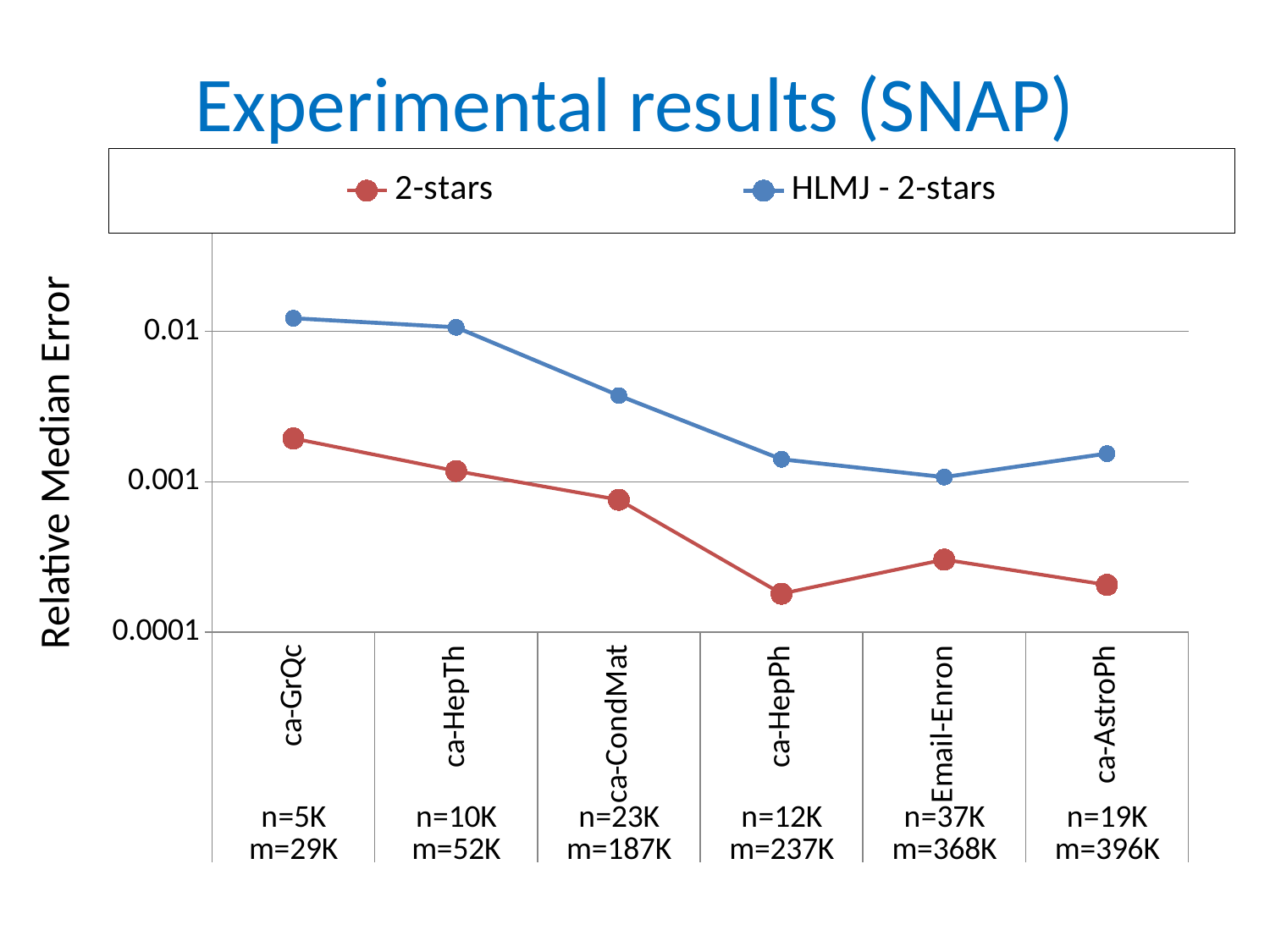
Is the HLMJ - 2-stars value for ca-GrQc greater or less than 0.01? greater For which dataset is the 2-stars series lowest? ca-HepPh How many series does the legend list? 2 What is the title of the slide containing the chart? Experimental results (SNAP) Is the 2-stars value for ca-HepPh greater or less than 0.001? less For which dataset is the HLMJ - 2-stars series highest? ca-GrQc Is the HLMJ - 2-stars value for ca-CondMat greater or less than 0.01? less At ca-HepPh, which series has the larger value, 2-stars or HLMJ - 2-stars? HLMJ - 2-stars What kind of chart is shown on the slide? line chart What is the label of the y axis? Relative Median Error How many datasets (categories) are plotted along the x axis? 6